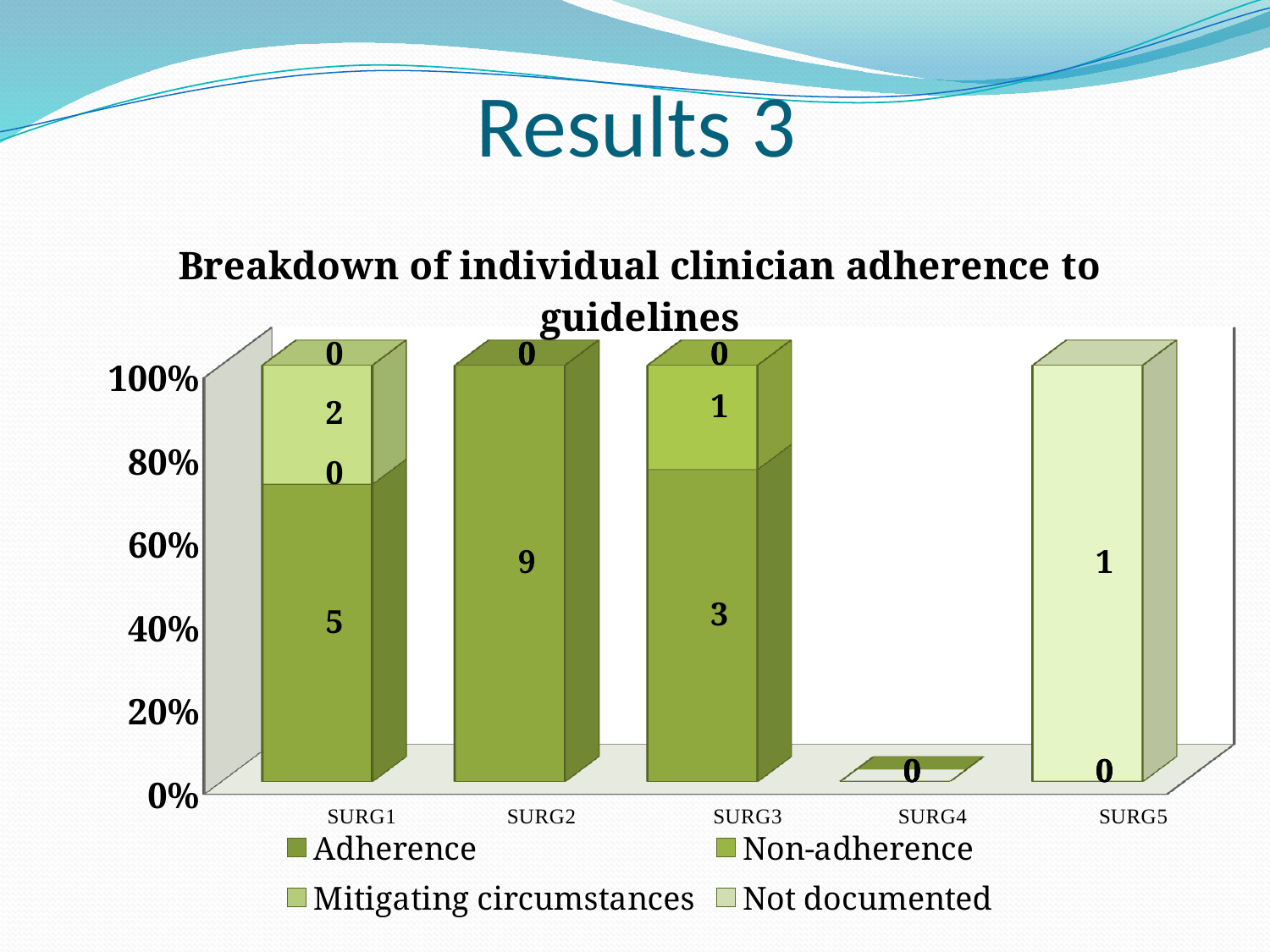
How many series does the legend list? 4 What is the Adherence value for SURG2? 9 What is the difference between the Adherence values for SURG2 and SURG1? 4 Which is larger, the Adherence value for SURG1 or for SURG3? SURG1 What is the Adherence value for SURG1? 5 How many surgeons (categories) are shown on the x axis? 5 What is the title of the chart? Breakdown of individual clinician adherence to guidelines What is the Mitigating circumstances value for SURG1? 2 What is the Mitigating circumstances value for SURG3? 0 What is the Adherence value for SURG3? 3 Which surgeon has the highest Adherence value? SURG2 What is the Not documented value for SURG5? 1